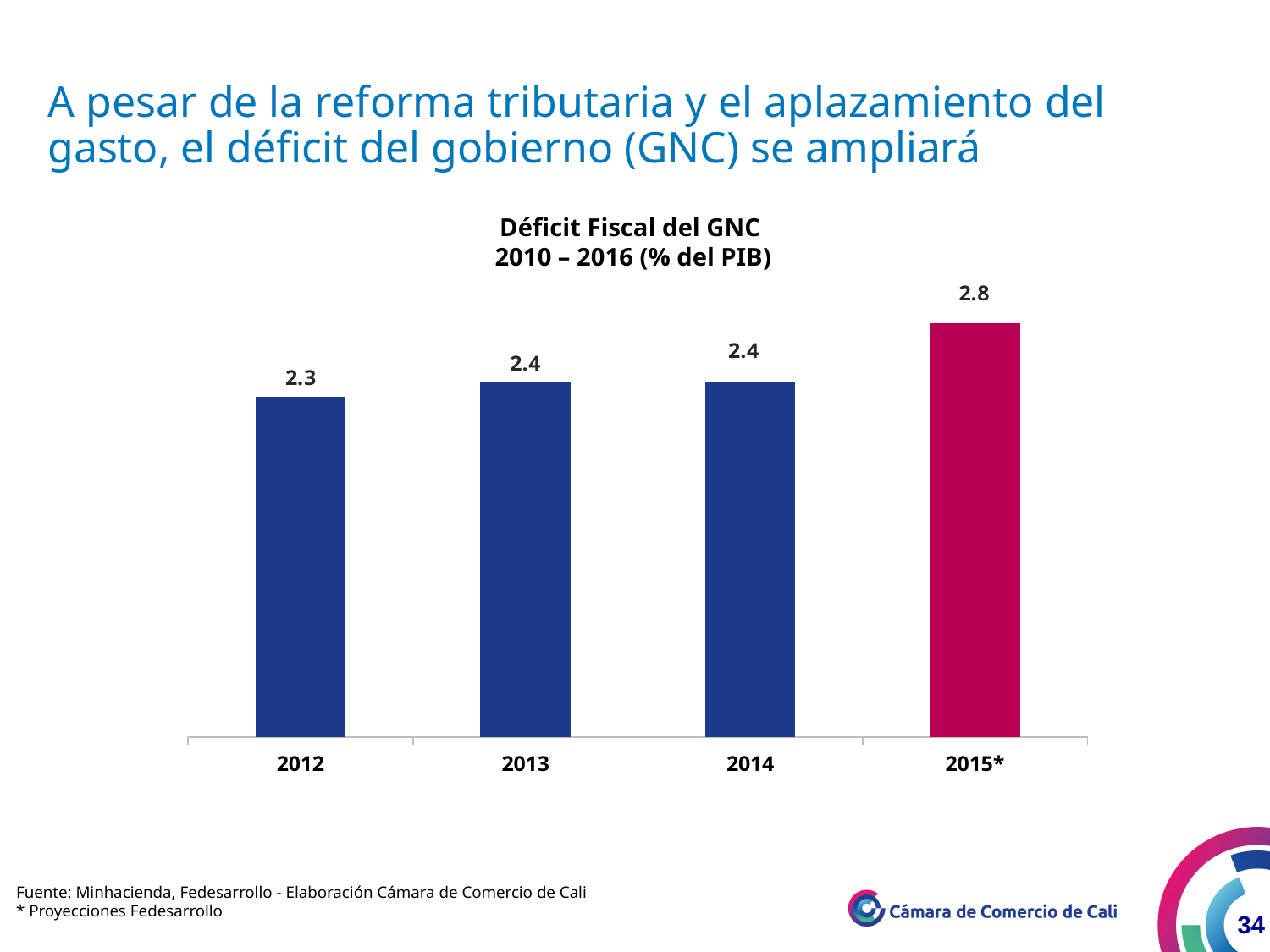
Which year has the lowest fiscal deficit in the chart? 2012 What kind of chart is shown on the slide? Bar chart Which year has the highest fiscal deficit in the chart? 2015* What is the title of the chart? Déficit Fiscal del GNC 2010 – 2016 (% del PIB) Do the values rise or fall from 2012 to 2015*? Rise What is the value shown for 2014? 2.4 What is the difference between the values for 2015* and 2012? 0.5 How many years are plotted in the chart? 4 What is the fiscal deficit value shown for 2015*? 2.8 What is the difference between the values for 2015* and 2014? 0.4 Which is larger, the value for 2013 or the value for 2015*? 2015* What is the fiscal deficit value shown for 2012? 2.3